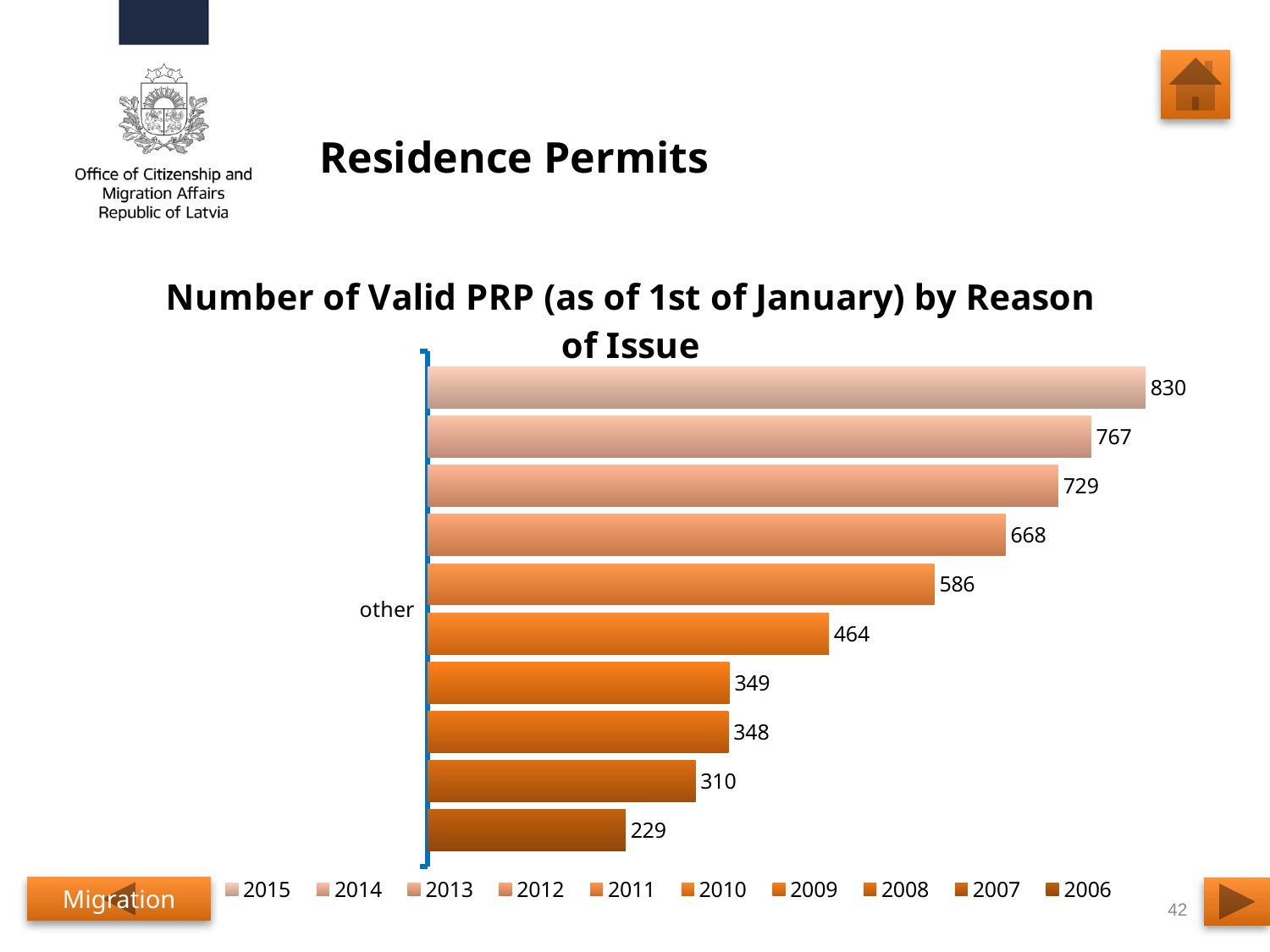
What is the value for 2008 in the 'other' category? 348 How many series does the legend list? 10 What is the value for 2011 in the 'other' category? 586 What is the value for 2015 in the 'other' category? 830 What is the value for 2006 in the 'other' category? 229 What is the difference between the values for 2015 and 2006? 601 Which is larger, the value for 2012 or the value for 2010? 2012 What is the difference between the values for 2014 and 2013? 38 Which year has the lowest value? 2006 What is the title of the chart? Number of Valid PRP (as of 1st of January) by Reason of Issue What kind of chart is shown on the slide? bar chart Which year has the highest value? 2015